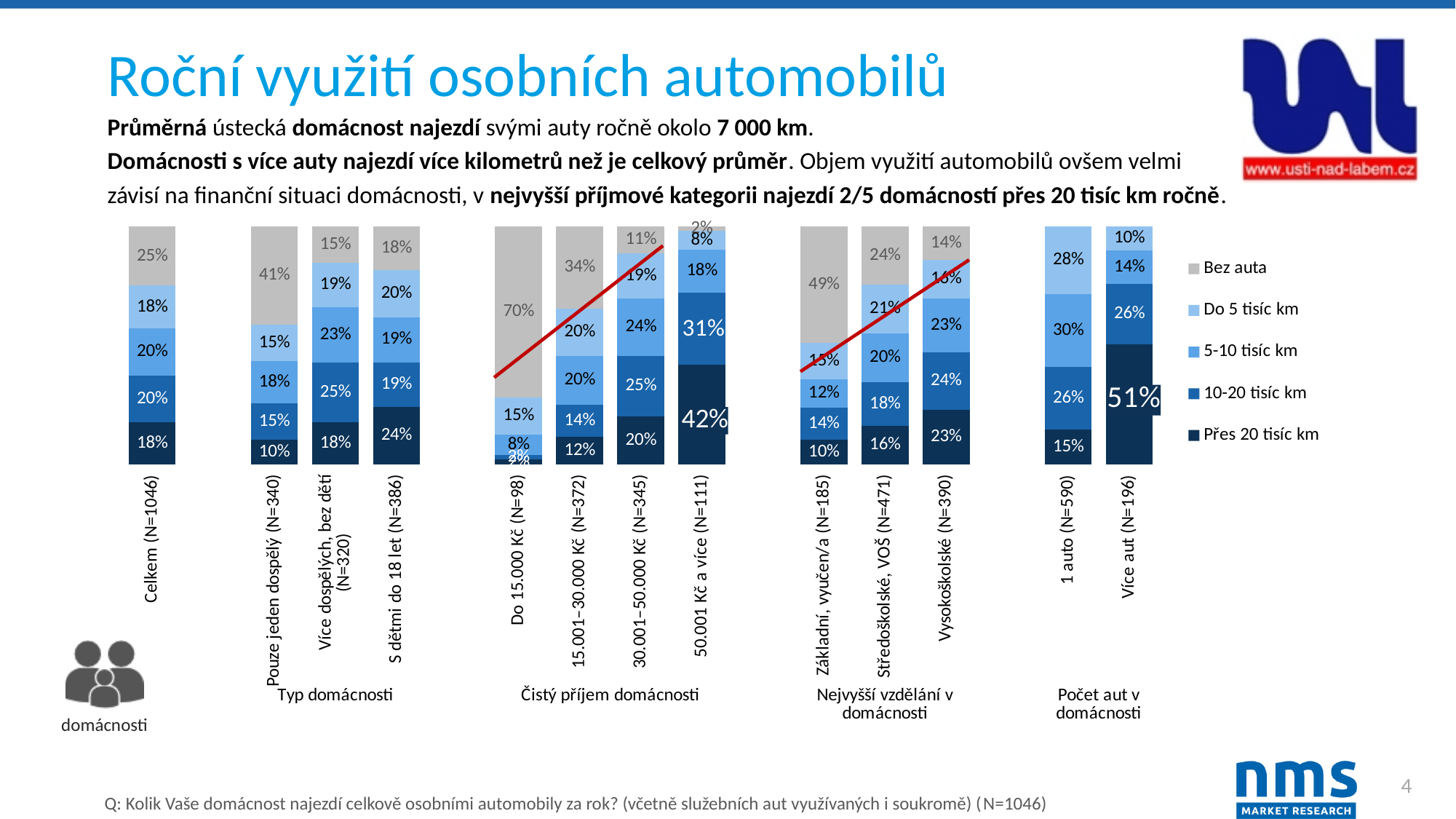
What is the value for '10-20 tisíc km' in the '50.001 Kč a více (N=111)' bar? 31% What is the title of the slide containing the chart? Roční využití osobních automobilů What is the value for 'Bez auta' in the 'Celkem (N=1046)' bar? 25% Which is larger: the 'Bez auta' value for 'Pouze jeden dospělý (N=340)' or for 'S dětmi do 18 let (N=386)'? Pouze jeden dospělý (N=340) How many series does the legend list? 5 What is the value for 'Přes 20 tisíc km' in the 'Více aut (N=196)' bar? 51% What is the value for 'Bez auta' in the 'Do 15.000 Kč (N=98)' bar? 70% What kind of chart is shown on the slide? stacked bar chart What is the value for 'Přes 20 tisíc km' in the 'Vysokoškolské (N=390)' bar? 23% Which category has the highest share of 'Přes 20 tisíc km'? Více aut (N=196) Which category has the highest share of 'Bez auta'? Do 15.000 Kč (N=98) What is the difference between the 'Přes 20 tisíc km' values for 'Více aut (N=196)' and '1 auto (N=590)'? 36 percentage points